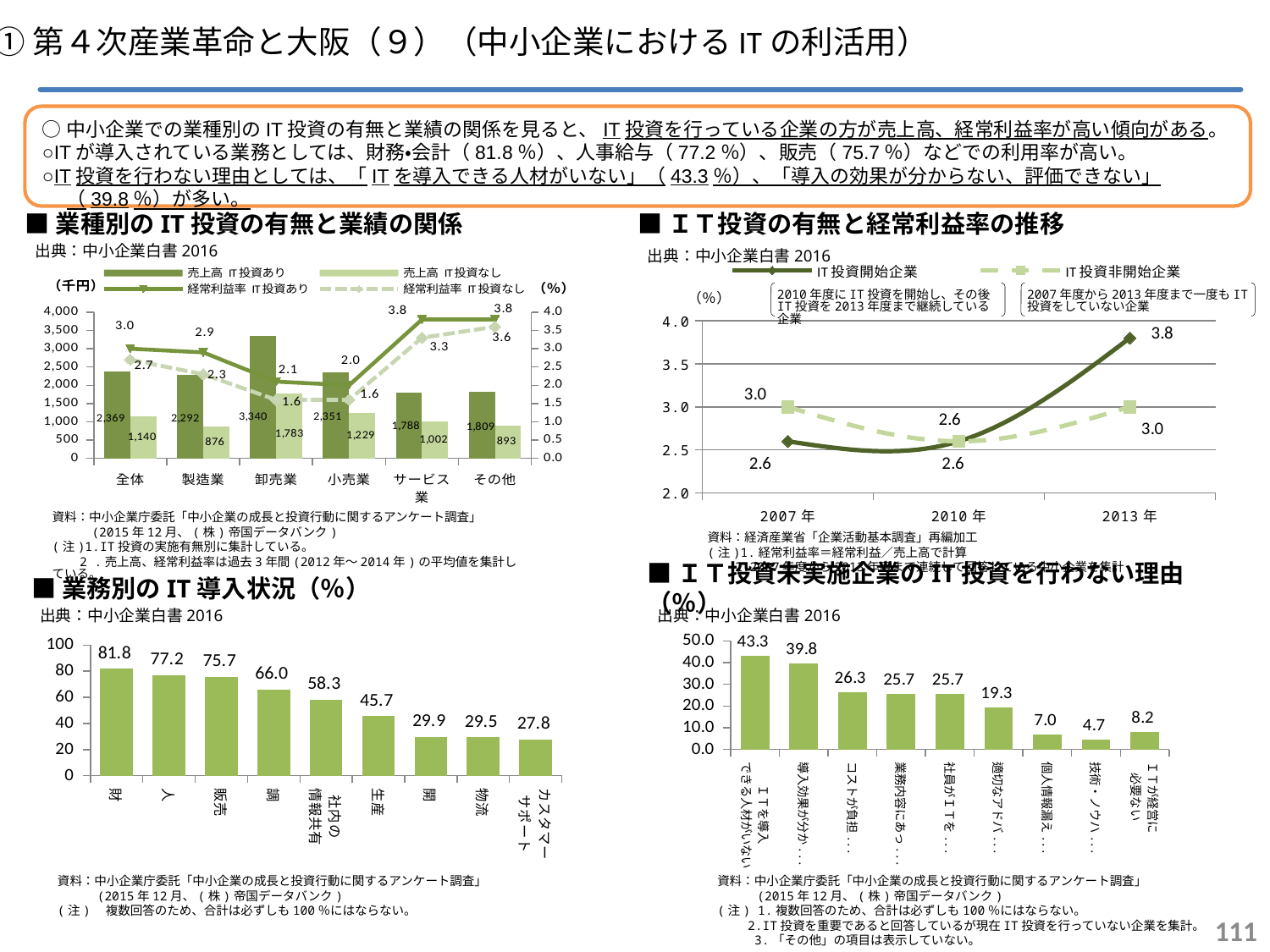
In the chart titled 業務別のIT導入状況（%）, what is the value for カスタマーサポート? 27.8 How many series does the legend list in the chart titled 業種別のIT投資の有無と業績の関係? 4 In the chart titled 業務別のIT導入状況（%）, how many categories are plotted? 9 What kind of chart is the one titled IT投資の有無と経常利益率の推移? Line chart In the chart titled IT投資未実施企業のIT投資を行わない理由（%）, which category has the highest value? ITを導入できる人材がいない In the chart titled 業種別のIT投資の有無と業績の関係, what is the difference between the 売上高 IT投資あり and 売上高 IT投資なし values for 全体? 1,229 In the chart titled IT投資の有無と経常利益率の推移, what is the value for IT投資開始企業 in 2013年? 3.8 In the chart titled 業種別のIT投資の有無と業績の関係, what is the 売上高 IT投資あり value for 卸売業? 3,340 In the chart titled IT投資未実施企業のIT投資を行わない理由（%）, what is the value for ITが経営に必要ない? 8.2 In the chart titled IT投資の有無と経常利益率の推移, which series has the higher value in 2007年, IT投資開始企業 or IT投資非開始企業? IT投資非開始企業 In the chart titled 業務別のIT導入状況（%）, what is the value for 販売? 75.7 In the chart titled 業種別のIT投資の有無と業績の関係, what is the 経常利益率 IT投資なし value for 製造業? 2.3